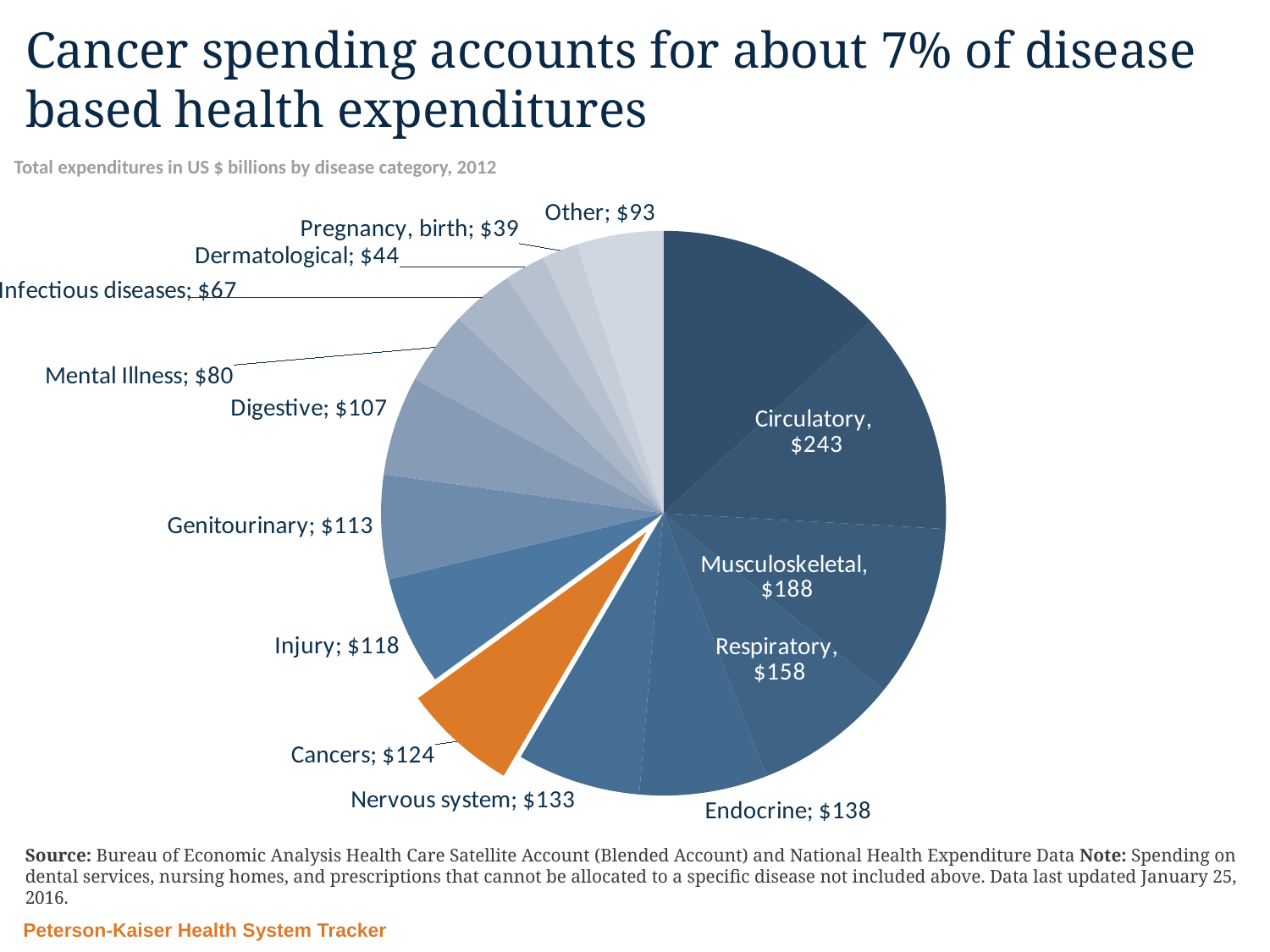
What is the difference between Cancers and Injury expenditures? $6 Which disease category has the lowest expenditure? Pregnancy, birth What is the value for Mental Illness? $80 What is the value for Cancers? $124 Which slice of the pie chart is highlighted in orange? Cancers What type of chart is shown on the slide? pie chart What is the difference between Circulatory and Musculoskeletal expenditures? $55 What is the value for Circulatory? $243 Which is larger, Respiratory or Endocrine? Respiratory What is the value for Pregnancy, birth? $39 How many disease categories are shown in the pie chart? 15